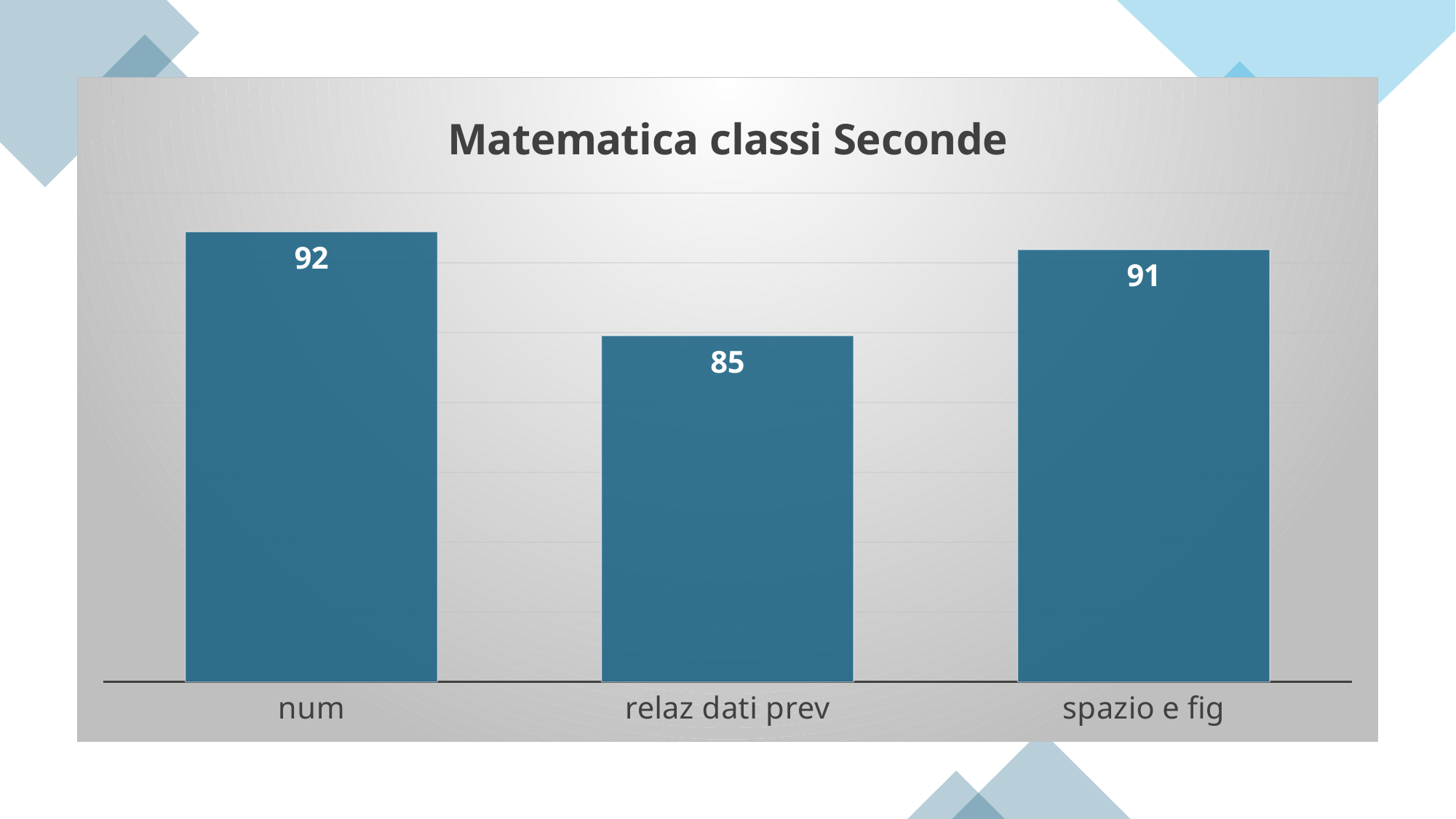
Which is larger, the value for num or the value for relaz dati prev? num Which category has the highest value? num What is the difference between the values for num and relaz dati prev? 7 What is the value for num? 92 Which is larger, the value for relaz dati prev or the value for spazio e fig? spazio e fig What is the title of the chart? Matematica classi Seconde How many categories are shown in the chart? 3 What kind of chart is shown on the slide? bar chart Which category has the lowest value? relaz dati prev What is the value for spazio e fig? 91 What is the difference between the values for spazio e fig and relaz dati prev? 6 What is the value for relaz dati prev? 85